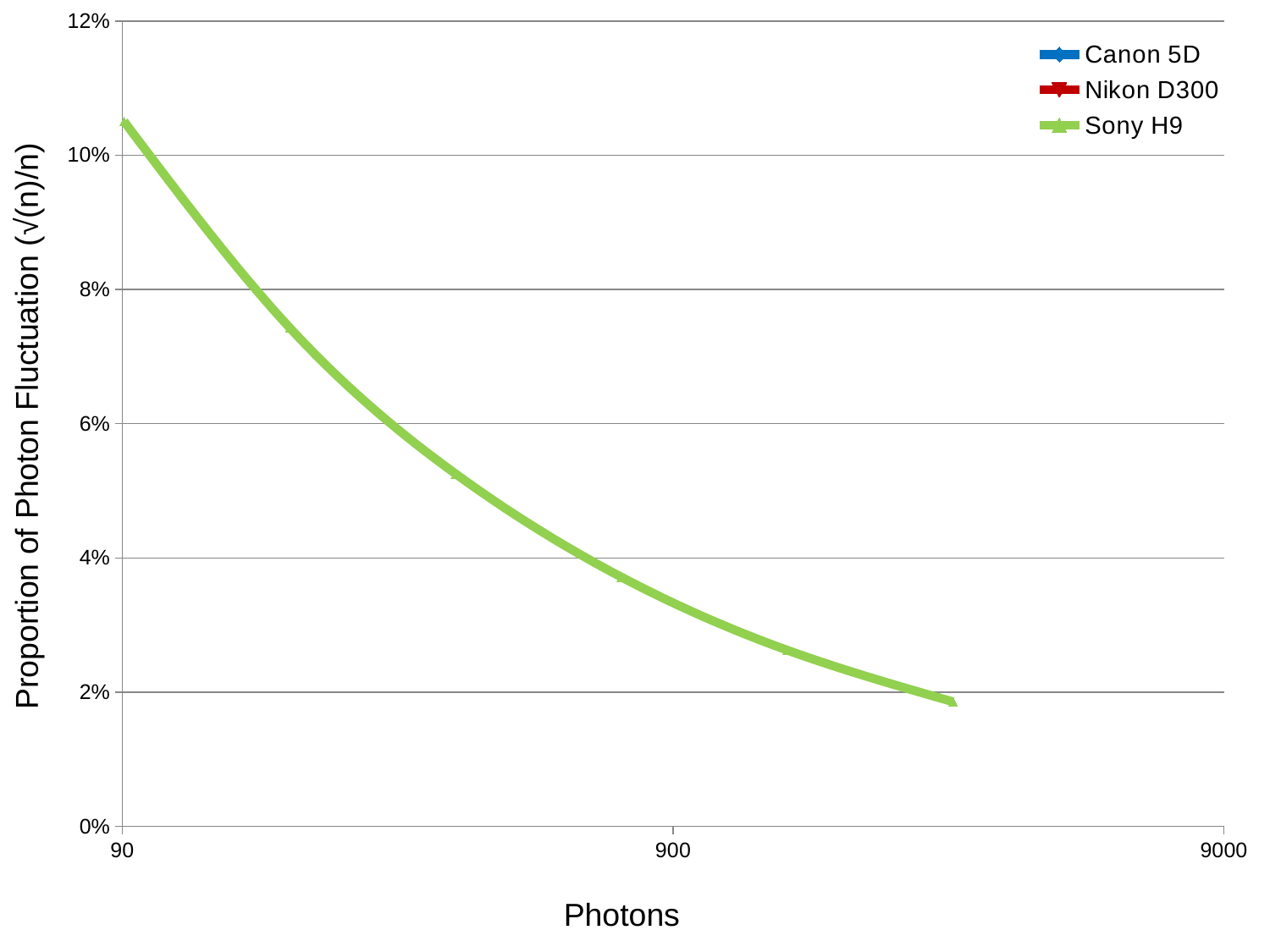
Which series are listed in the legend? Canon 5D, Nikon D300, Sony H9 Is the value of the Sony H9 line at its right-hand end greater or less than 2%? less Is the value of the Sony H9 line at 900 photons greater or less than 2%? greater Is the value of the Sony H9 line at 90 photons greater or less than 10%? greater What is the title of the x axis? Photons Which is larger for the Sony H9 line: the value at 90 photons or the value at 900 photons? the value at 90 photons Do the plotted values rise or fall as the number of photons increases along the x axis? fall How many series does the legend list? 3 What kind of chart is shown on the slide? line chart What is the highest tick label shown on the y axis? 12%